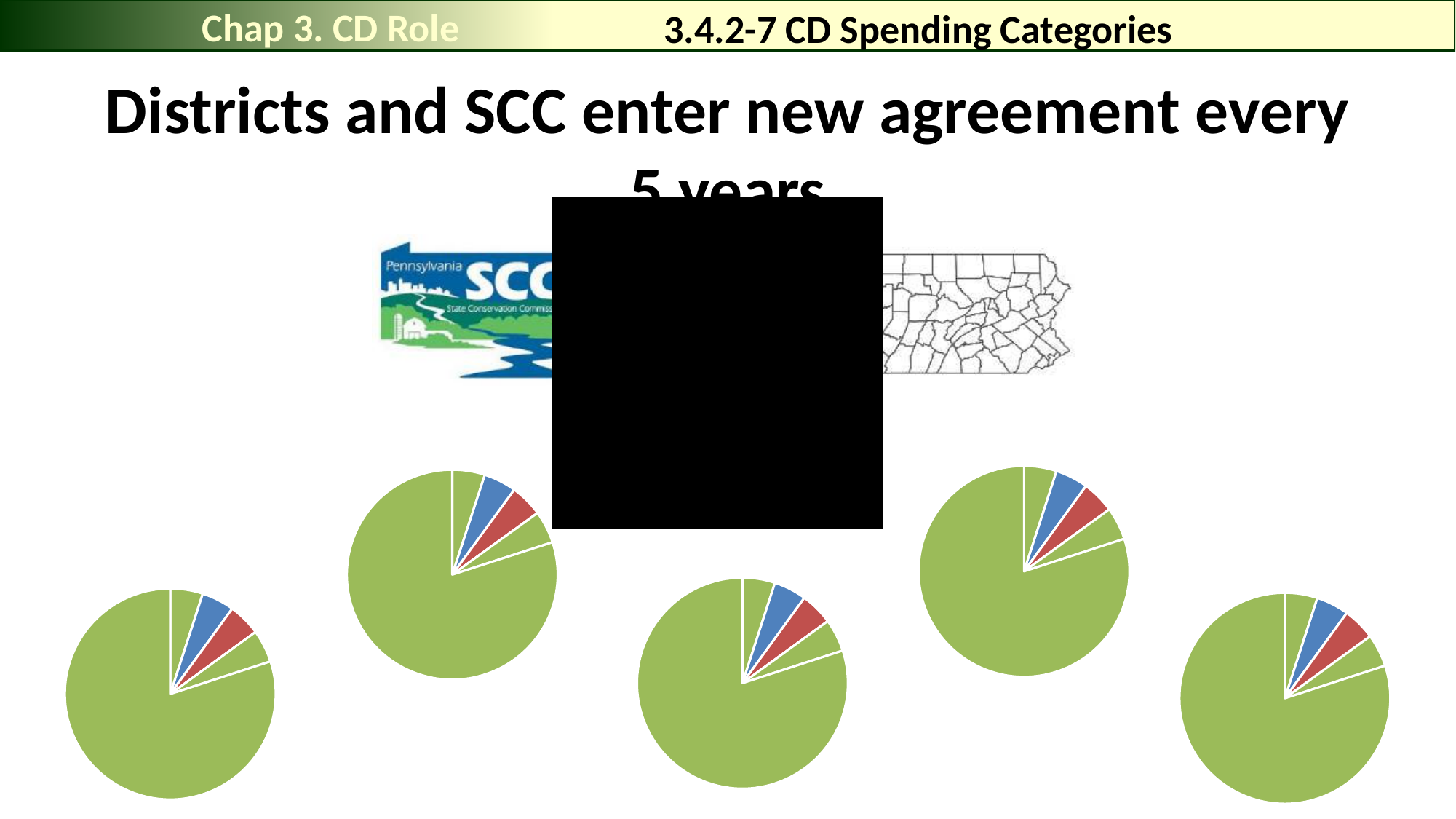
In the middle pie chart, which is larger, the red slice or the large green slice? green In the leftmost pie chart, which is larger, the blue slice or the green slice? green Do the pie charts on the slide have a legend? No How many pie charts are on the slide? 5 In the leftmost pie chart, which colour is the largest slice? green In the rightmost pie chart, which colour is the largest slice? green Do the pie charts on the slide show data labels? No What kind of chart is shown on the slide? pie chart